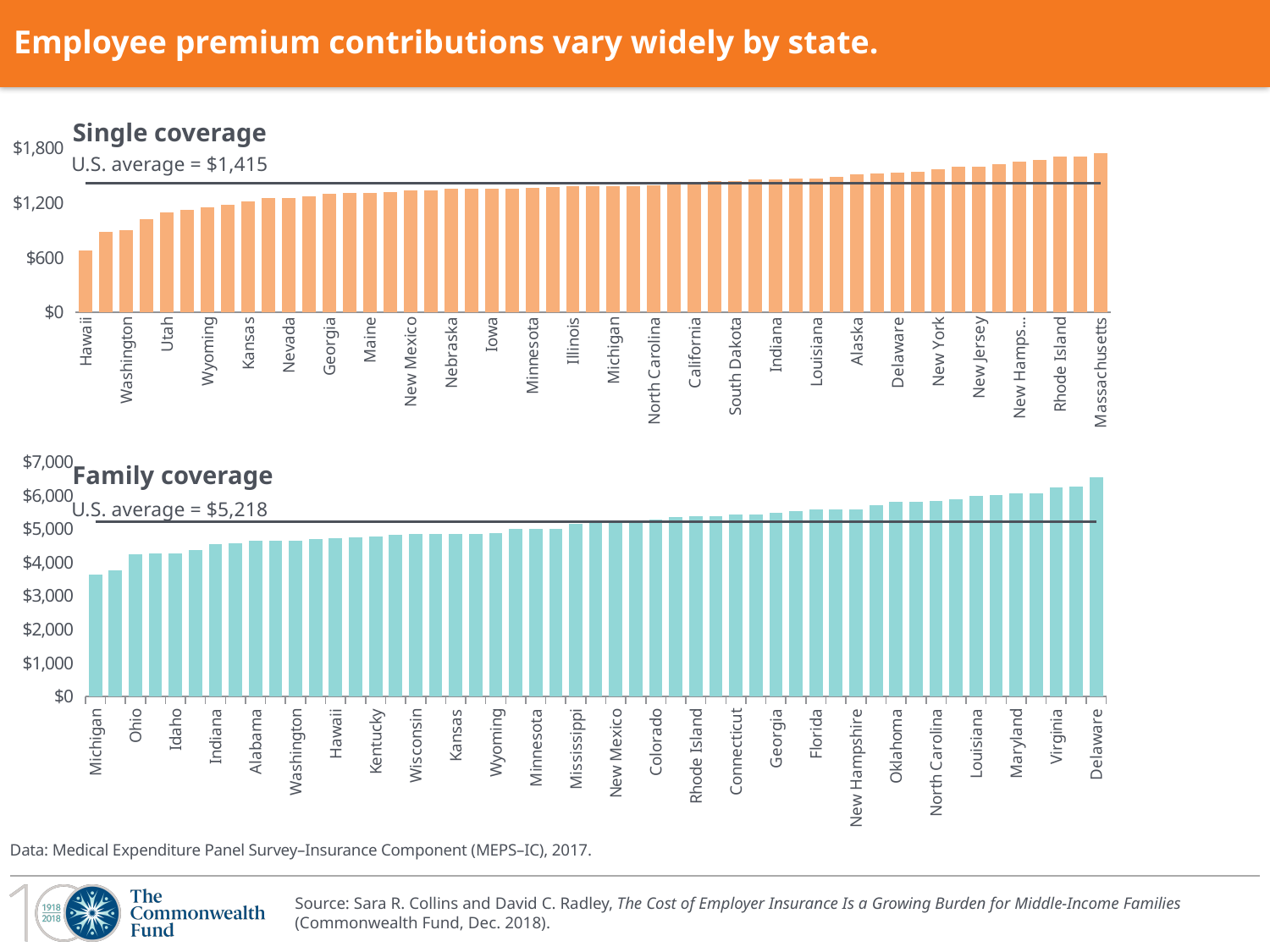
In the Family coverage chart, which state has the larger value, Michigan or Delaware? Delaware In the Family coverage chart, which state has the highest employee premium contribution? Delaware In the Family coverage chart, is the value for Delaware greater or less than $6,000? greater In the Single coverage chart, which state has the lowest employee premium contribution? Hawaii In the Family coverage chart, which state has the lowest employee premium contribution? Michigan In the Single coverage chart, is the value for Massachusetts greater or less than $1,200? greater In the Single coverage chart, which state has the highest employee premium contribution? Massachusetts In the Single coverage chart, do the bar values rise or fall from left to right? Rise In the Single coverage chart, is the value for Hawaii greater or less than $1,200? less What kind of chart is the Single coverage chart? Bar chart What is the U.S. average shown on the Family coverage chart? $5,218